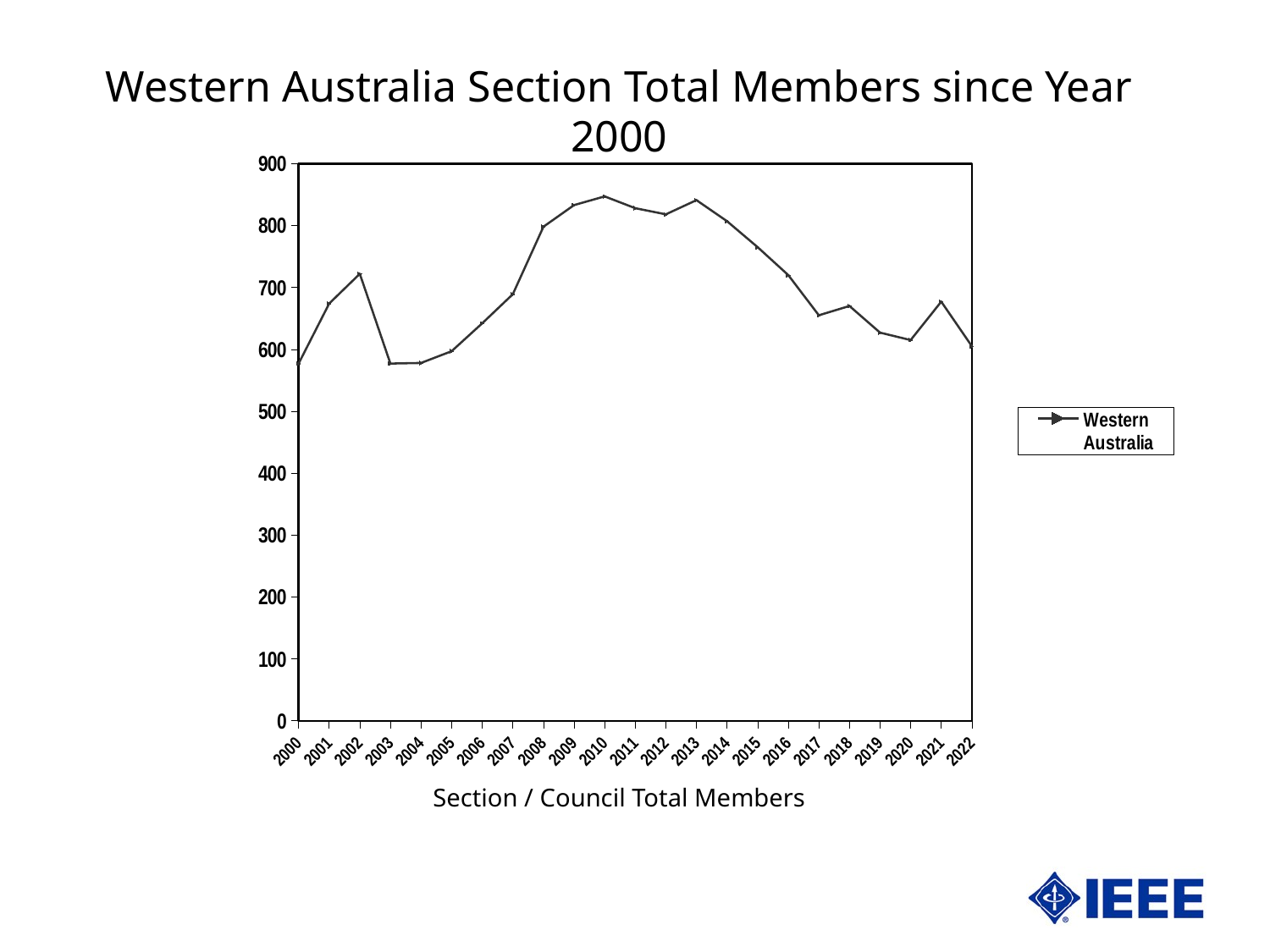
Is the value for 2010 greater or less than 800? greater What is the title of the chart? Western Australia Section Total Members since Year 2000 Is the value for 2015 greater or less than 700? greater What kind of chart is shown on the slide? line chart Do the values rise or fall from 2013 to 2017? fall What is the name of the series shown in the legend? Western Australia How many years are plotted along the x axis? 23 Is the value for 2017 greater or less than 700? less How many series does the legend list? 1 Which year has the larger value, 2002 or 2003? 2002 Which year has the larger value, 2013 or 2022? 2013